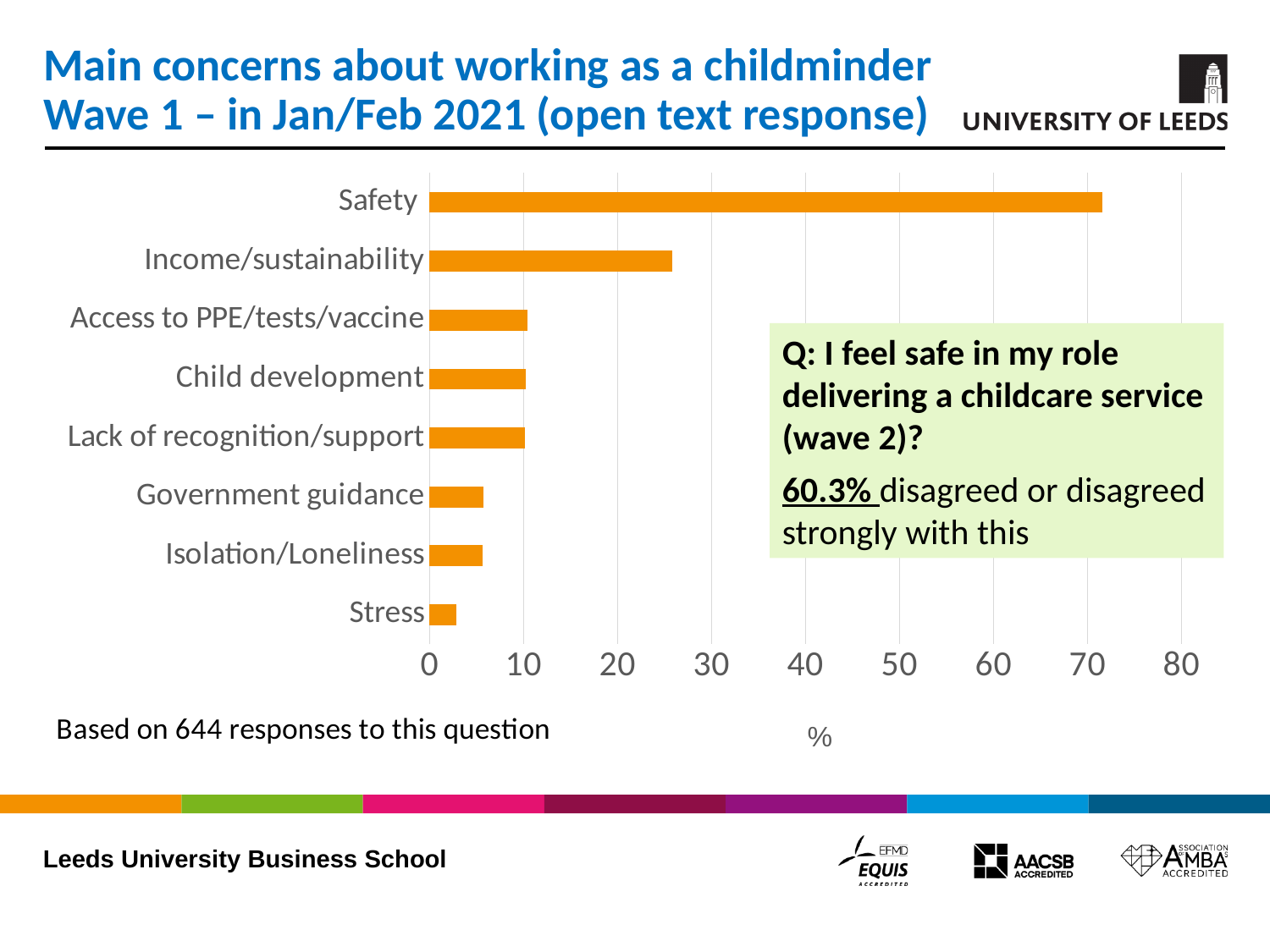
How many concern categories are plotted in the chart? 8 What kind of chart is shown on the slide? Bar chart Is the value for Income/sustainability greater or less than 30? less Is the value for Income/sustainability greater or less than 20? greater Is the value for Stress greater or less than 10? less Which concern has the lowest value in the chart? Stress Which has a larger value, Income/sustainability or Government guidance? Income/sustainability Which concern has the highest value in the chart? Safety Which has a larger value, Safety or Income/sustainability? Safety What unit is shown on the horizontal axis of the chart? %